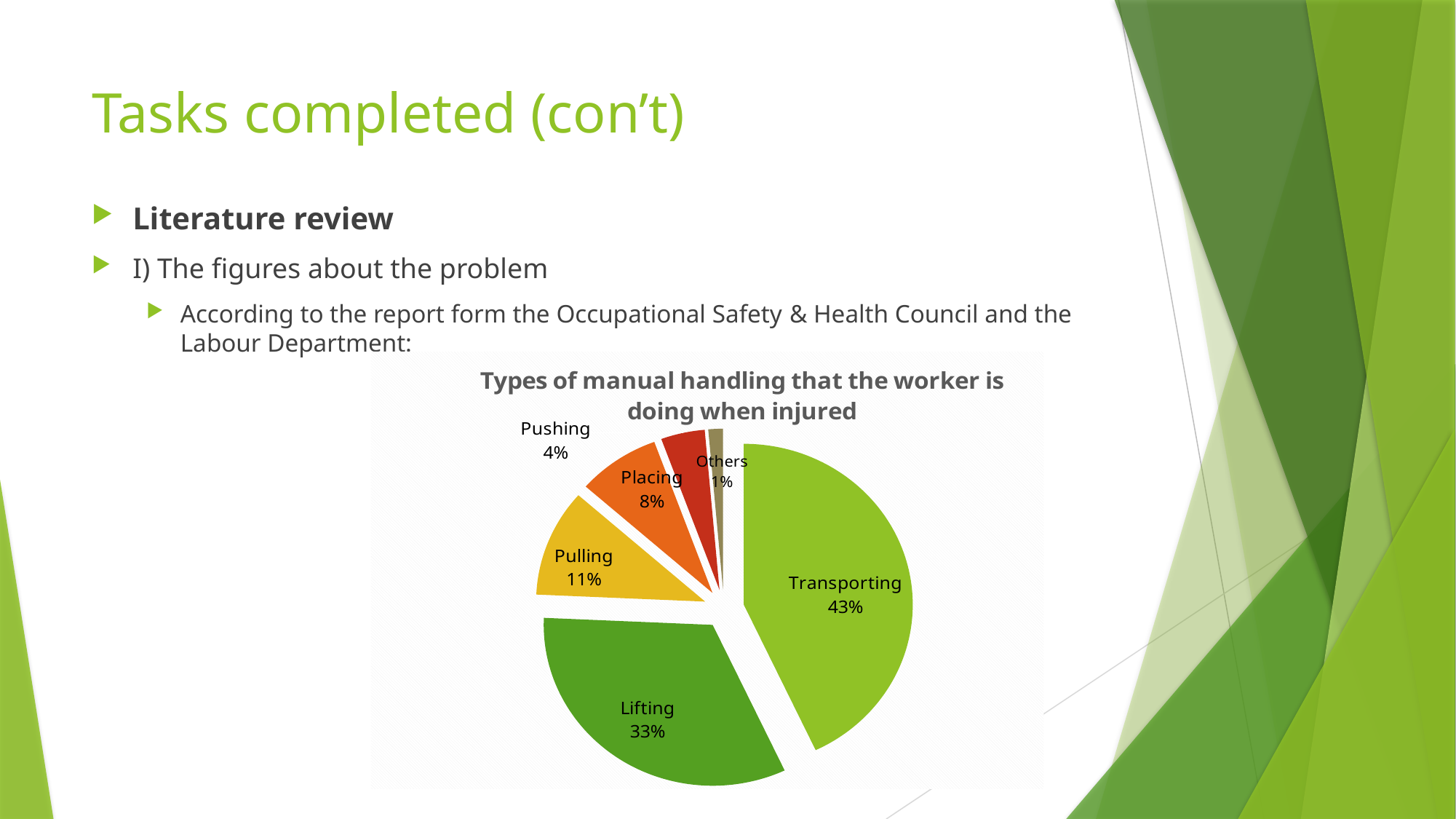
What percentage of the pie is Transporting? 43% Which is larger, the share for Pulling or the share for Placing? Pulling What percentage of the pie is Pushing? 4% What percentage of the pie is Lifting? 33% What percentage of the pie is Pulling? 11% What is the difference in percentage points between Transporting and Lifting? 10 What type of chart is shown on the slide? pie chart How many categories are shown in the pie chart? 6 Which category has the largest share of the pie? Transporting What is the title of the chart? Types of manual handling that the worker is doing when injured What percentage of the pie is Placing? 8% Which category has the smallest share of the pie? Others